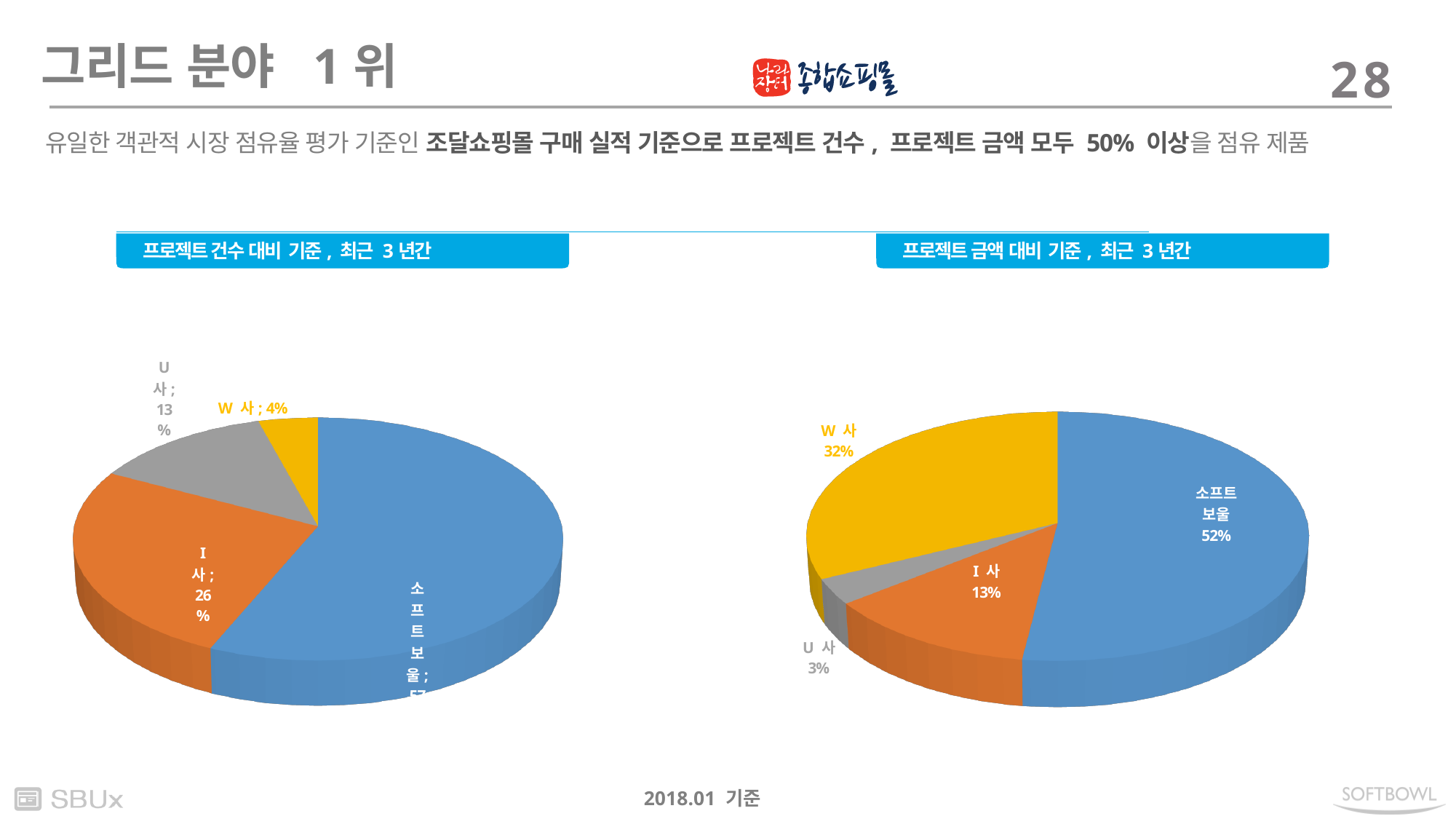
What kind of chart is used on this slide? Pie chart In the right pie chart (프로젝트 금액 대비 기준, 최근 3년간), how many percentage points larger is 소프트보울's share than W 사's share? 20% In the left pie chart (프로젝트 건수 대비 기준, 최근 3년간), what share does W 사 hold? 4% In the right pie chart (프로젝트 금액 대비 기준, 최근 3년간), which company has the smallest slice? U 사 In the left pie chart (프로젝트 건수 대비 기준, 최근 3년간), which is larger, the share of I 사 or the share of U 사? I 사 In the right pie chart (프로젝트 금액 대비 기준, 최근 3년간), what share does 소프트보울 hold? 52% In the right pie chart (프로젝트 금액 대비 기준, 최근 3년간), what share does W 사 hold? 32% In the left pie chart (프로젝트 건수 대비 기준, 최근 3년간), which company has the smallest slice? W 사 In the left pie chart (프로젝트 건수 대비 기준, 최근 3년간), what share does U 사 hold? 13% In the left pie chart (프로젝트 건수 대비 기준, 최근 3년간), what share does I 사 hold? 26% In the right pie chart (프로젝트 금액 대비 기준, 최근 3년간), which company has the largest slice? 소프트보울 In the right pie chart (프로젝트 금액 대비 기준, 최근 3년간), what share does U 사 hold? 3%